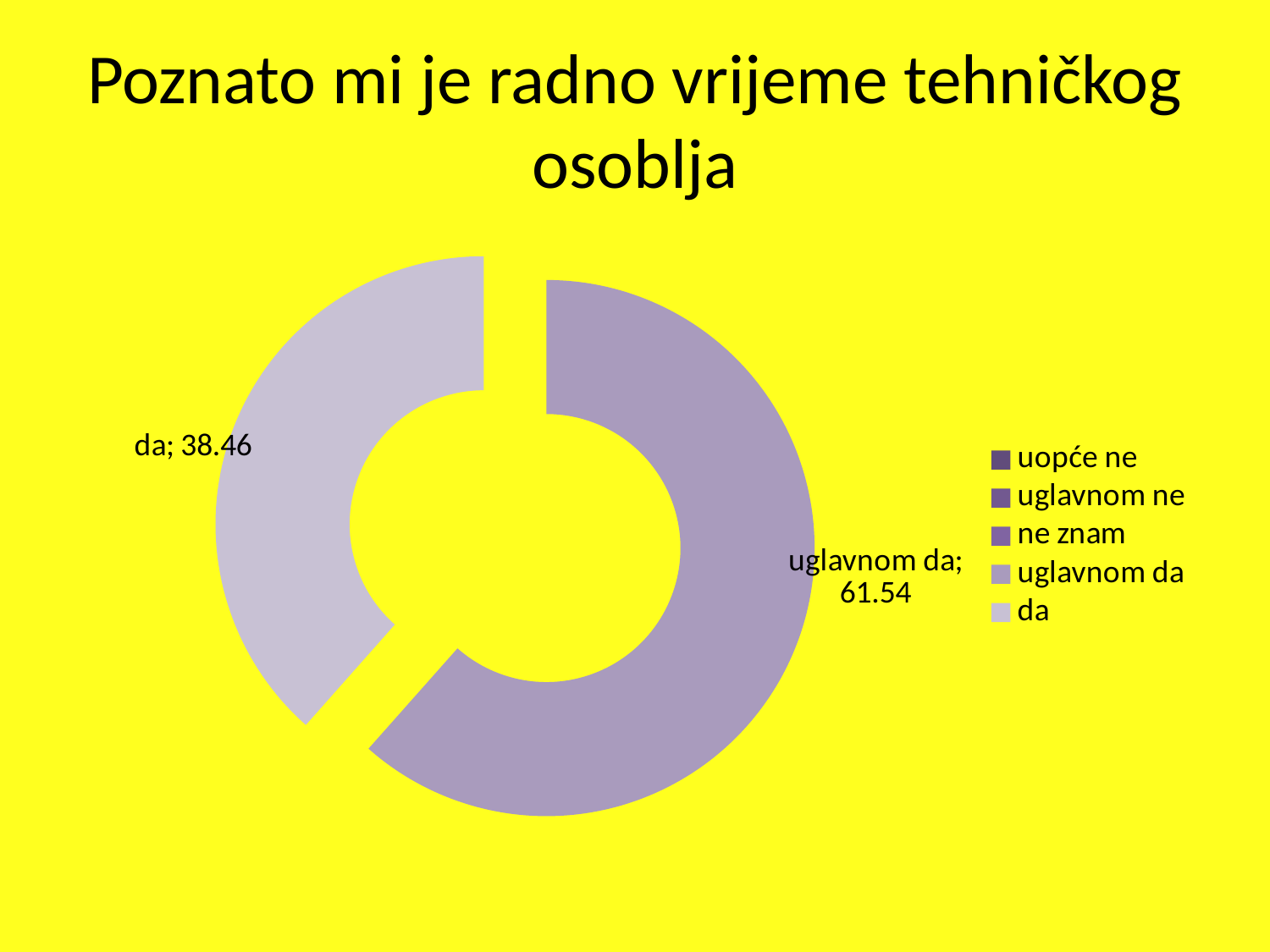
How many entries does the legend list? 5 How many slices with data labels are plotted in the chart? 2 What kind of chart is shown on the slide? doughnut chart Which legend entry is listed first? uopće ne Which of the plotted slices has the smallest value? da What is the difference between the values for "uglavnom da" and "da"? 23.08 What is the title of the slide? Poznato mi je radno vrijeme tehničkog osoblja What is the total of the two labelled slice values? 100 Which slice has the largest value? uglavnom da What is the value shown for the "uglavnom da" slice? 61.54 What is the value shown for the "da" slice? 38.46 Which is larger, the value for "uglavnom da" or the value for "da"? uglavnom da